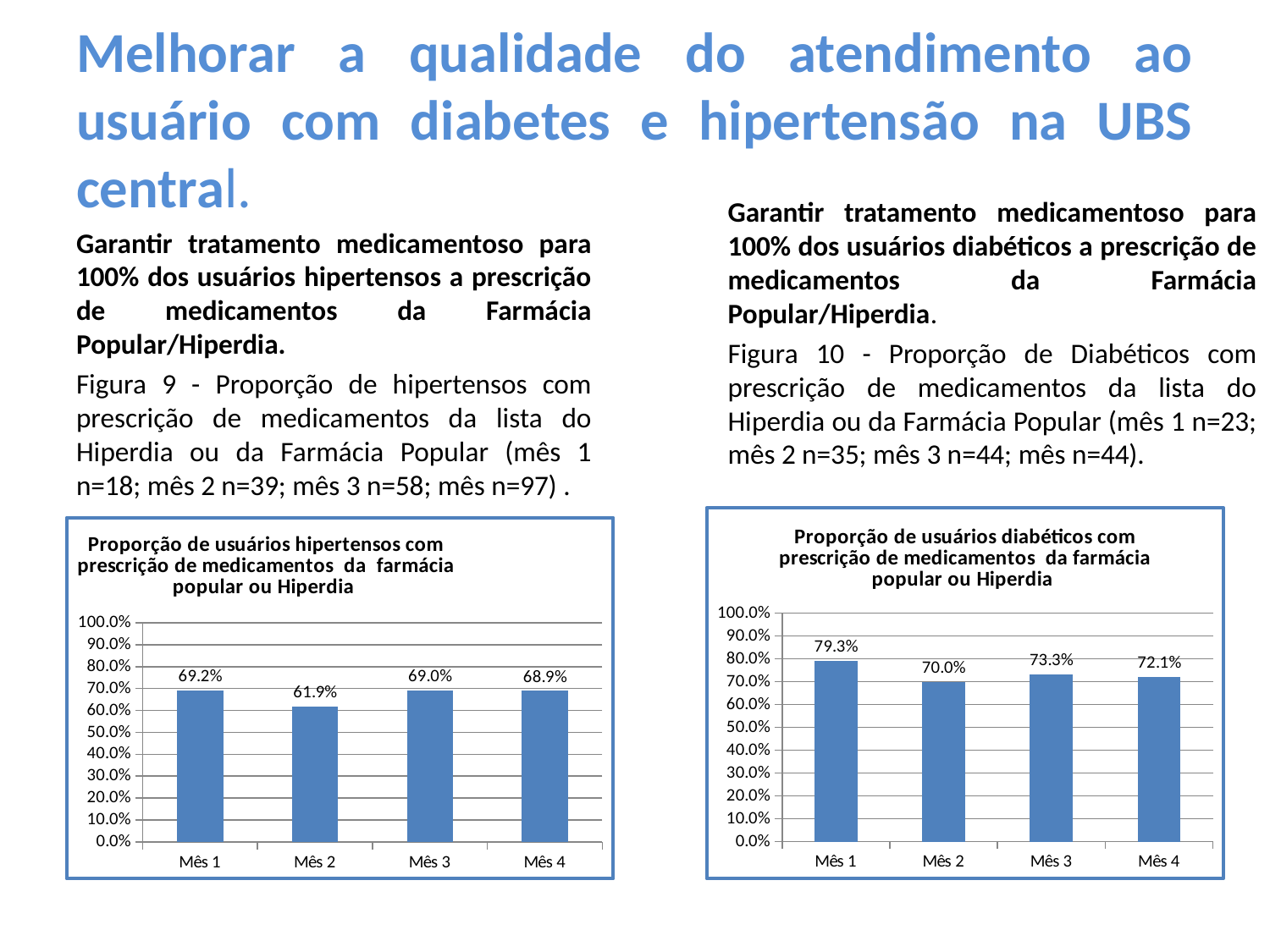
In the right chart (diabéticos), what is the value for Mês 1? 79.3% In the left chart (hipertensos), is the value for Mês 2 greater or less than 70.0%? less What kind of chart is the right chart (diabéticos)? bar chart In the left chart (hipertensos), what is the difference between the values for Mês 1 and Mês 2? 7.3% In the right chart (diabéticos), which is larger, the value for Mês 3 or the value for Mês 4? Mês 3 In the right chart (diabéticos), what is the difference between the values for Mês 1 and Mês 2? 9.3% In the right chart (diabéticos), what is the value for Mês 4? 72.1% How many months are shown on the x axis of the left chart (hipertensos)? 4 In the right chart (diabéticos), which month has the highest value? Mês 1 In the left chart (hipertensos), what is the value for Mês 2? 61.9% In the right chart (diabéticos), which month has the lowest value? Mês 2 In the left chart (hipertensos), which month has the lowest value? Mês 2